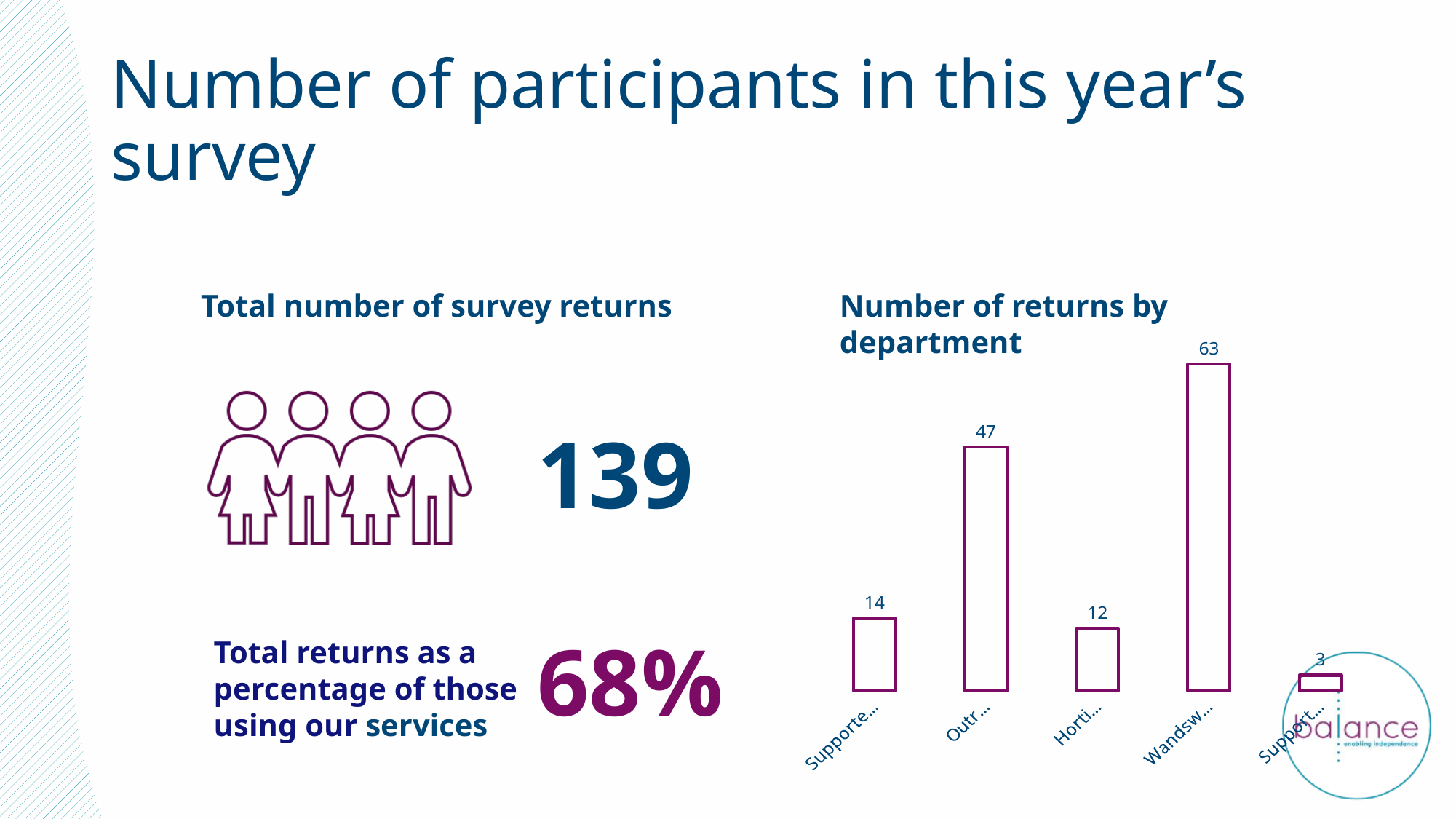
In the 'Number of returns by department' chart, what is the value of the third bar from the left (labelled 'Horti…')? 12 In the 'Number of returns by department' chart, what is the highest value shown? 63 In the 'Number of returns by department' chart, what is the difference between the fourth bar (63) and the second bar (47)? 16 In the 'Number of returns by department' chart, what is the lowest value shown? 3 In the 'Number of returns by department' chart, what is the value of the second bar from the left (labelled 'Outr…')? 47 In the 'Number of returns by department' chart, what is the value of the rightmost bar? 3 What is the title of the bar chart on the right of the slide? Number of returns by department In the 'Number of returns by department' chart, which is larger: the first bar from the left or the third bar from the left? the first bar (14) What type of chart is 'Number of returns by department'? bar chart How many bars are shown in the 'Number of returns by department' chart? 5 In the 'Number of returns by department' chart, what is the value of the fourth bar from the left (labelled 'Wandsw…')? 63 In the 'Number of returns by department' chart, what is the value of the first bar on the left? 14